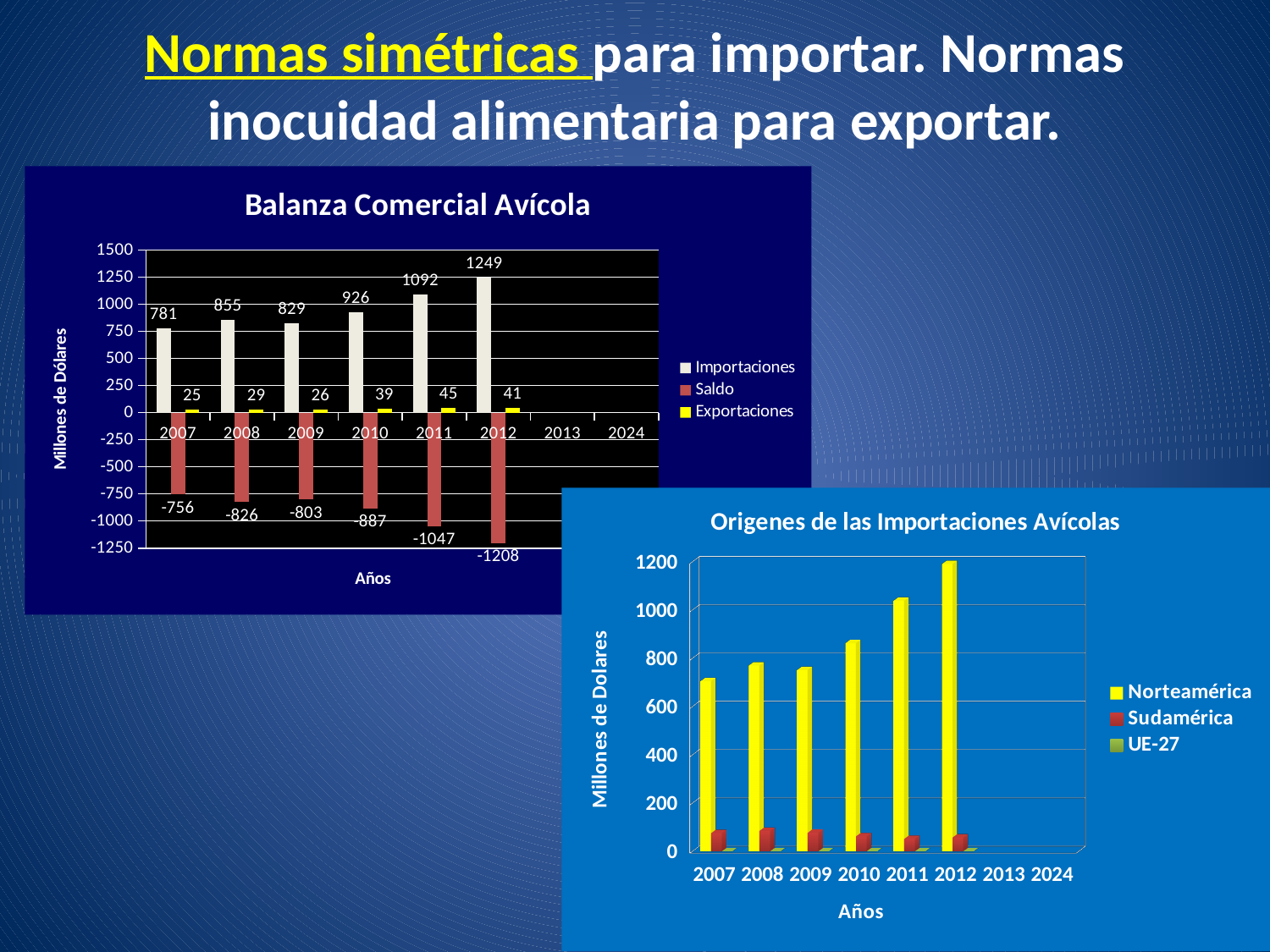
In the 'Balanza Comercial Avícola' chart, what is the value of Importaciones for 2012? 1249 What type of chart is 'Origenes de las Importaciones Avícolas'? bar chart In the 'Balanza Comercial Avícola' chart, what is the Exportaciones value for 2011? 45 In the 'Origenes de las Importaciones Avícolas' chart, is the Norteamérica value for 2012 greater or less than 1000? greater In the 'Balanza Comercial Avícola' chart, which year has the lowest Exportaciones value? 2007 In the 'Balanza Comercial Avícola' chart, do the Importaciones values generally rise or fall from 2009 to 2012? rise In the 'Balanza Comercial Avícola' chart, what is the difference between Importaciones in 2012 and 2011? 157 In the 'Balanza Comercial Avícola' chart, what is the Saldo value for 2009? -803 In the 'Origenes de las Importaciones Avícolas' chart, is the Norteamérica value for 2007 greater or less than 800? less In the 'Balanza Comercial Avícola' chart, which year has the highest Importaciones value? 2012 In the 'Balanza Comercial Avícola' chart, how many series does the legend list? 3 In the 'Balanza Comercial Avícola' chart, is the Importaciones value larger in 2008 or in 2009? 2008